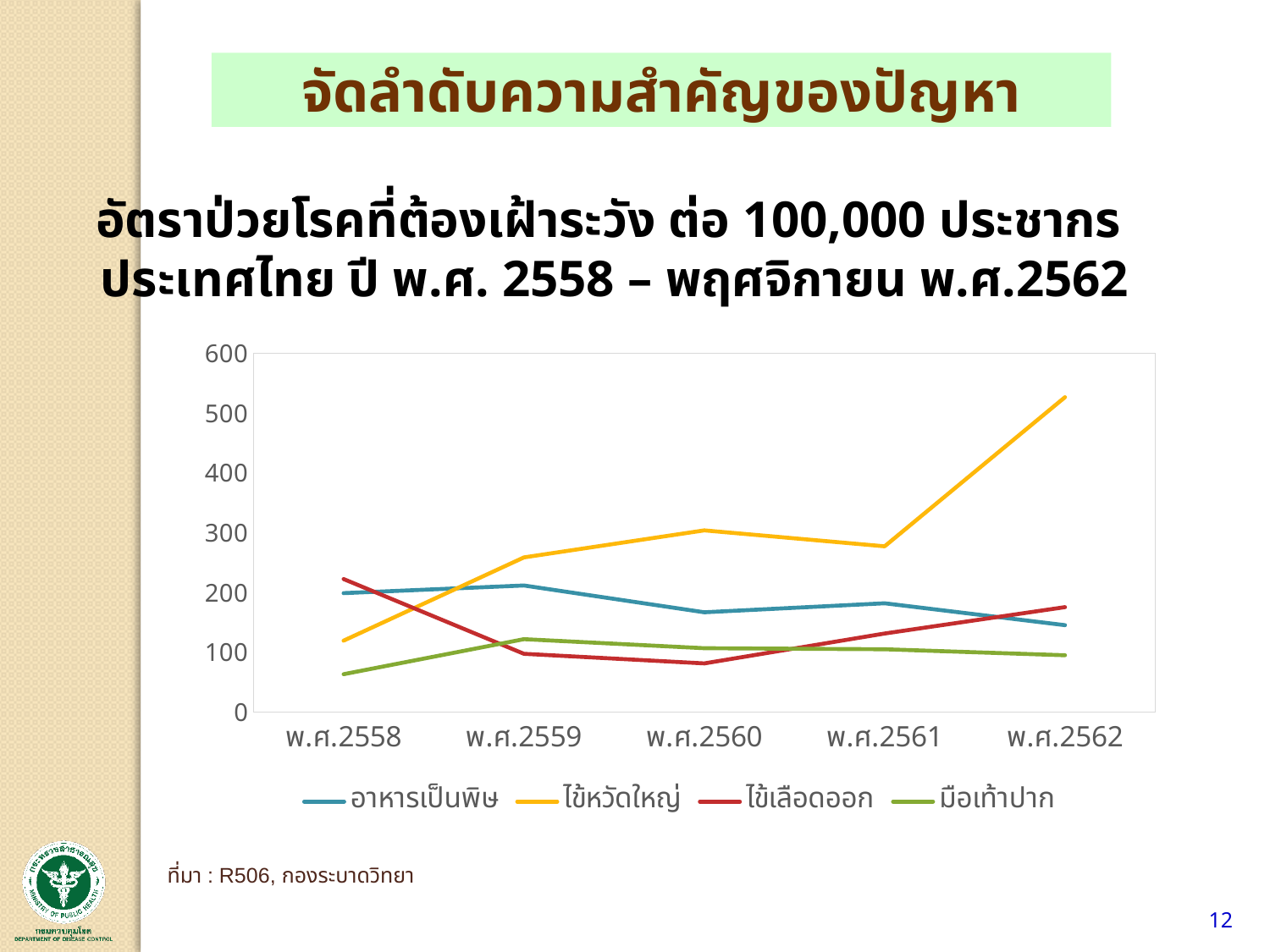
How many years are shown on the x axis of the chart? 5 Which colour is used for the ไข้เลือดออก line in the chart? red How many series does the chart legend list? 4 Which series has the lowest value in พ.ศ.2558? มือเท้าปาก In which year is the ไข้หวัดใหญ่ line at its lowest value? พ.ศ.2558 In which year does the ไข้หวัดใหญ่ line reach its highest value? พ.ศ.2562 Is the value for มือเท้าปาก in พ.ศ.2558 greater or less than 100? less Is the value for ไข้หวัดใหญ่ in พ.ศ.2562 greater or less than 500? greater In พ.ศ.2562, which is larger: ไข้หวัดใหญ่ or อาหารเป็นพิษ? ไข้หวัดใหญ่ What kind of chart is shown on the slide? line chart Which series has the highest value in พ.ศ.2562? ไข้หวัดใหญ่ Does the ไข้หวัดใหญ่ line rise or fall from พ.ศ.2561 to พ.ศ.2562? rise